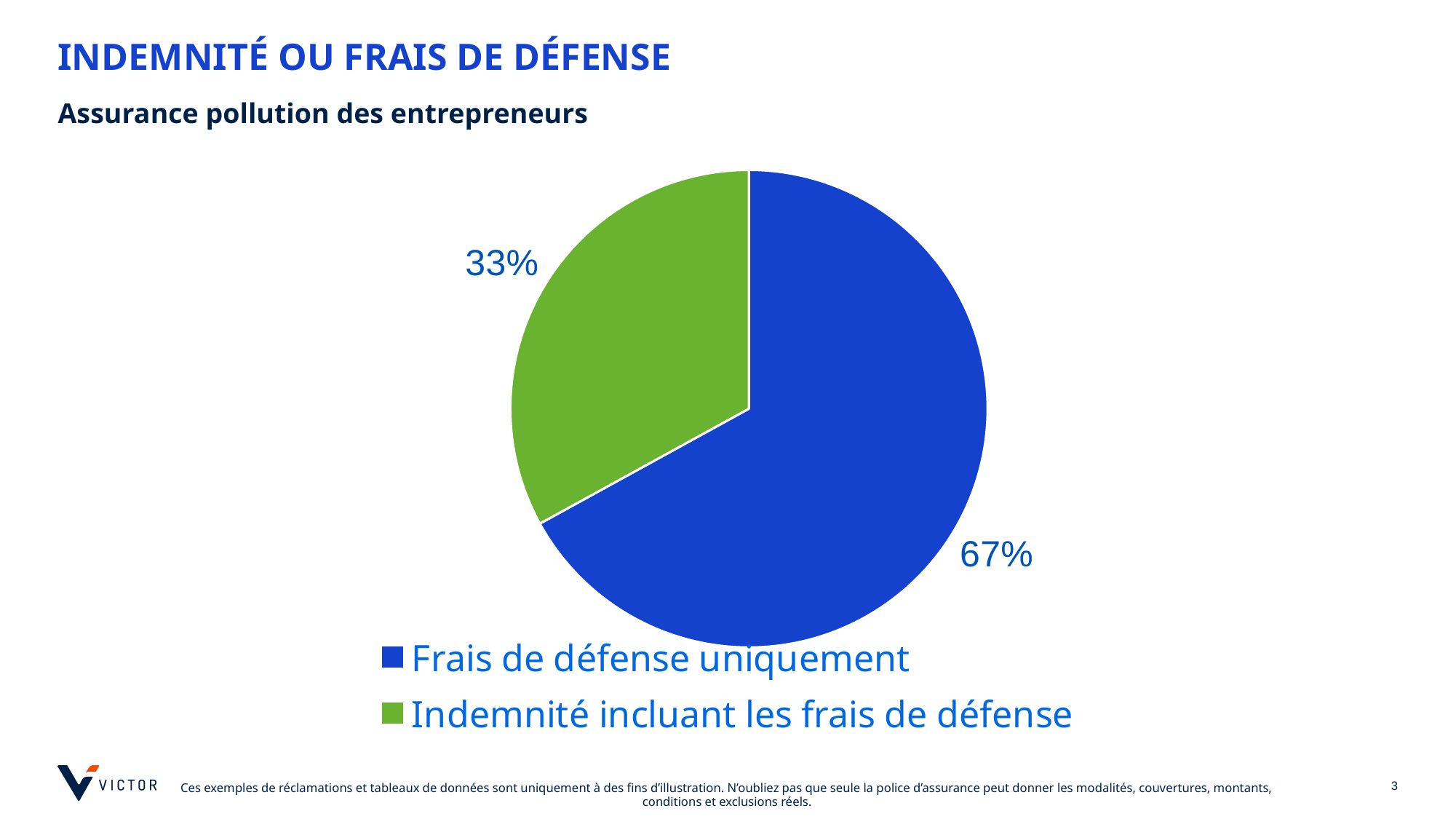
What colour is the slice for "Frais de défense uniquement"? Blue What colour is the slice for "Indemnité incluant les frais de défense"? Green How many slices does the pie chart have? 2 What share of the pie does "Frais de défense uniquement" represent? 67% What share of the pie does "Indemnité incluant les frais de défense" represent? 33% What kind of chart is shown on the slide? Pie chart What is the difference in percentage points between the "Frais de défense uniquement" slice and the "Indemnité incluant les frais de défense" slice? 34 How many entries does the legend list? 2 Which category has the largest slice of the pie? Frais de défense uniquement Which category has the smallest slice of the pie? Indemnité incluant les frais de défense Which is larger: the slice for "Frais de défense uniquement" or the slice for "Indemnité incluant les frais de défense"? Frais de défense uniquement